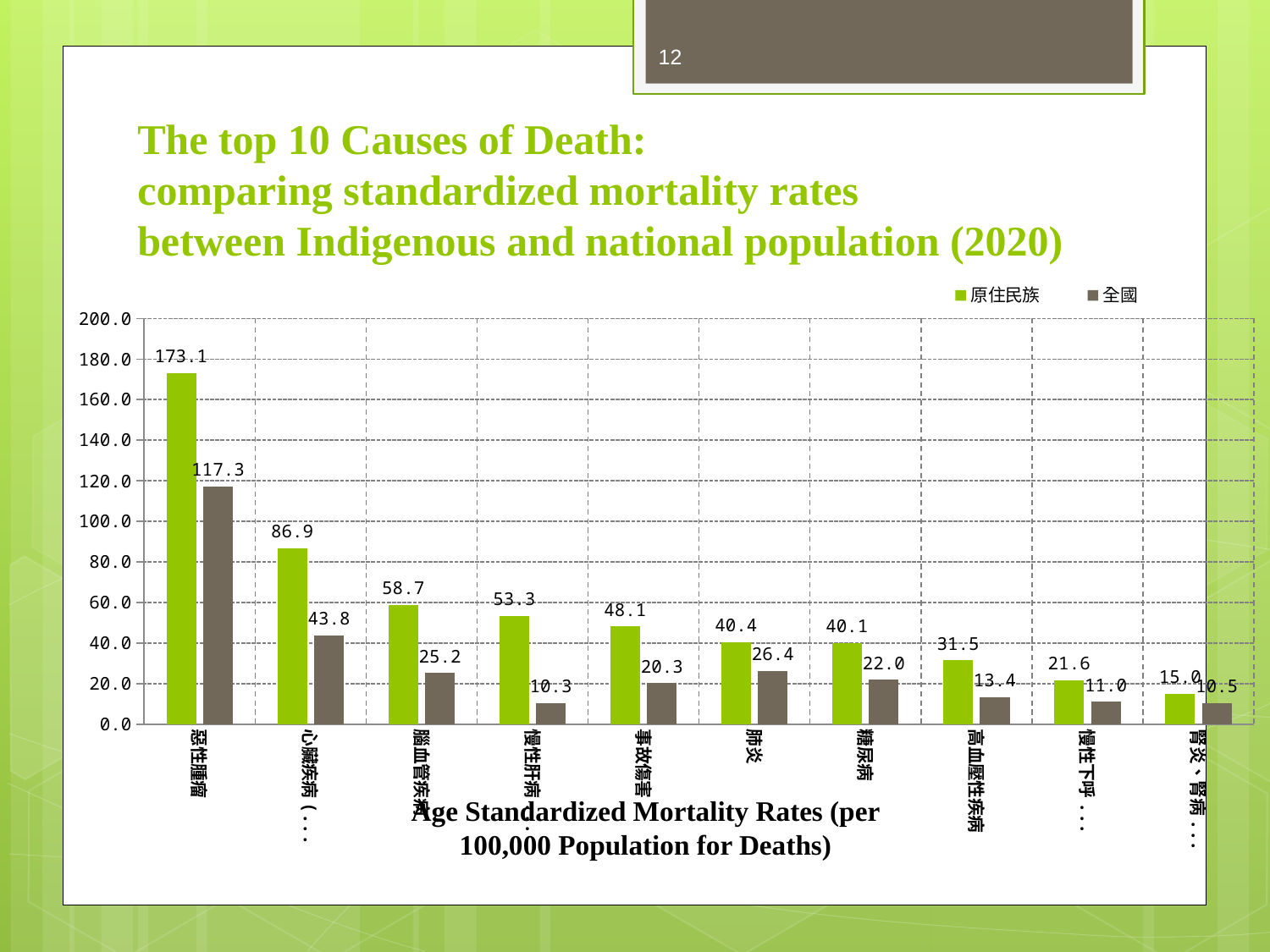
How many categories are shown on the x axis? 10 What is the difference between the 原住民族 and 全國 values for 慢性肝病? 43.0 How many series does the legend list? 2 What is the value for 原住民族 for 肺炎? 40.4 What kind of chart is shown on the slide? Bar chart Which is larger for 事故傷害: the 原住民族 value or the 全國 value? 原住民族 What is the value for 原住民族 for 惡性腫瘤? 173.1 Which category has the highest value for 原住民族? 惡性腫瘤 Which category has the lowest value for 全國? 慢性肝病 What is the value for 全國 for 惡性腫瘤? 117.3 What is the value for 全國 for 糖尿病? 22.0 Do the 原住民族 values rise or fall from left to right along the x axis? Fall